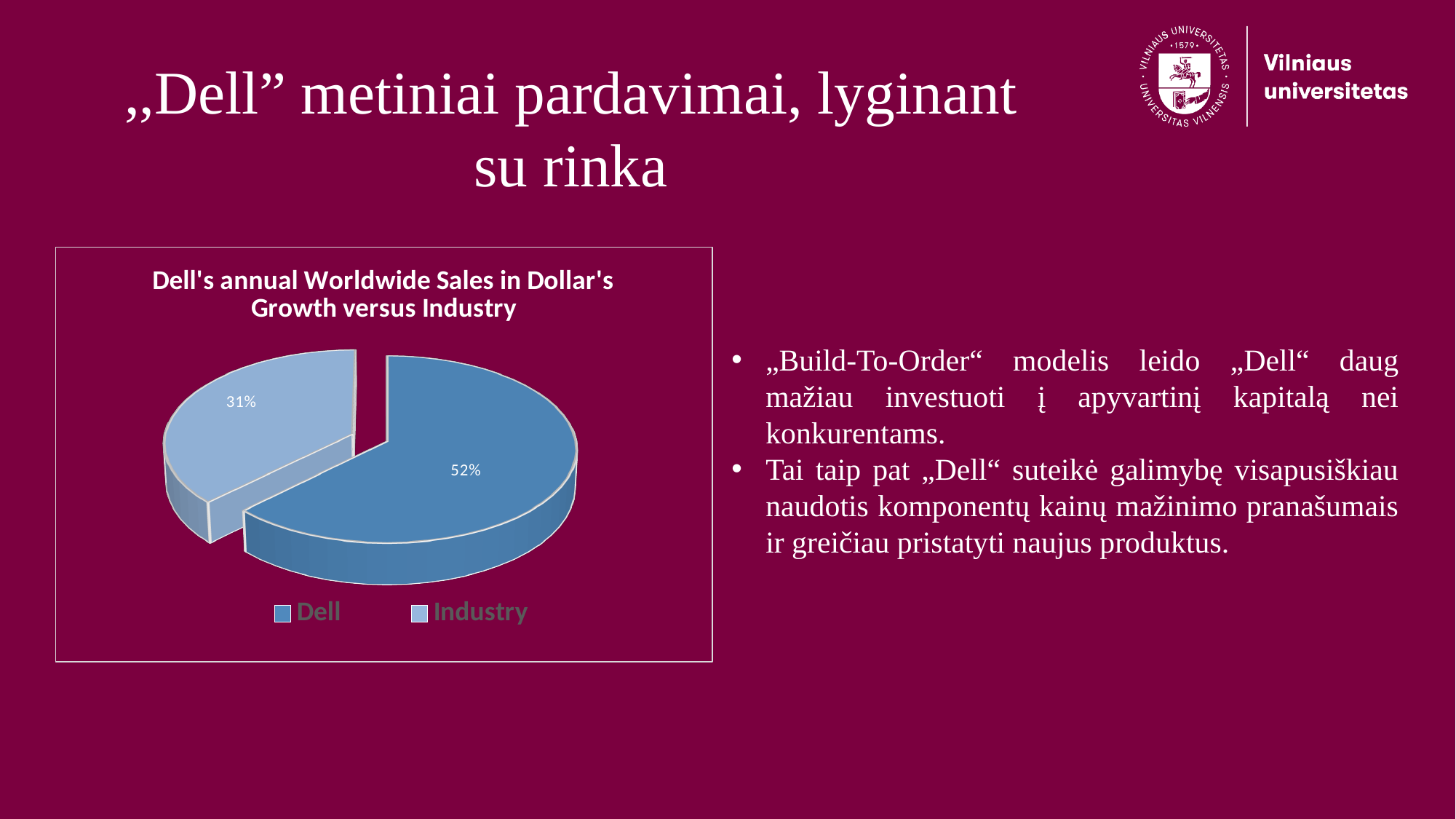
What value is labelled on the Dell slice of the pie chart? 52% What is the difference between the Dell value and the Industry value shown on the pie chart? 21 percentage points What is the title of the chart? Dell's annual Worldwide Sales in Dollar's Growth versus Industry Which legend entry is shown in the lighter blue colour? Industry What type of chart is shown on the slide? Pie chart Which slice of the pie chart is the smallest? Industry How many slices does the pie chart have? 2 How many entries does the chart legend list? 2 What value is labelled on the Industry slice of the pie chart? 31% Which is larger in the pie chart, Dell or Industry? Dell Which slice of the pie chart is the largest? Dell